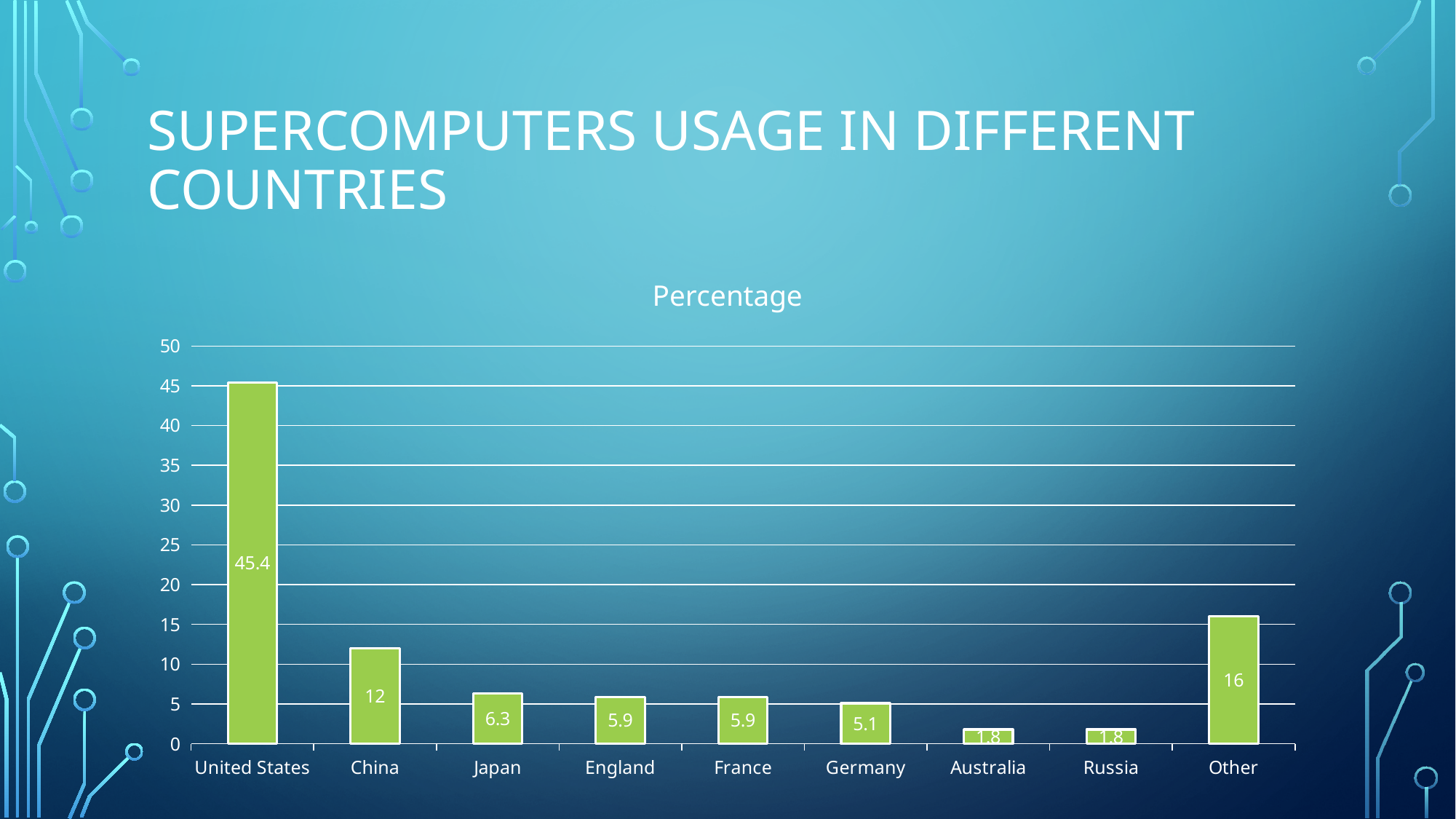
Which is larger, the value for China or the value for Other? Other What is the difference between the values for Japan and Germany? 1.2 What is the value for the United States? 45.4 What is the value for Other? 16 What is the title of the chart? Percentage Which category has the highest value? United States Is the value for Other greater or less than 15? greater What is the difference between the values for the United States and China? 33.4 What kind of chart is shown on the slide? bar chart What is the value for Germany? 5.1 What is the value for China? 12 How many categories are shown on the x axis? 9